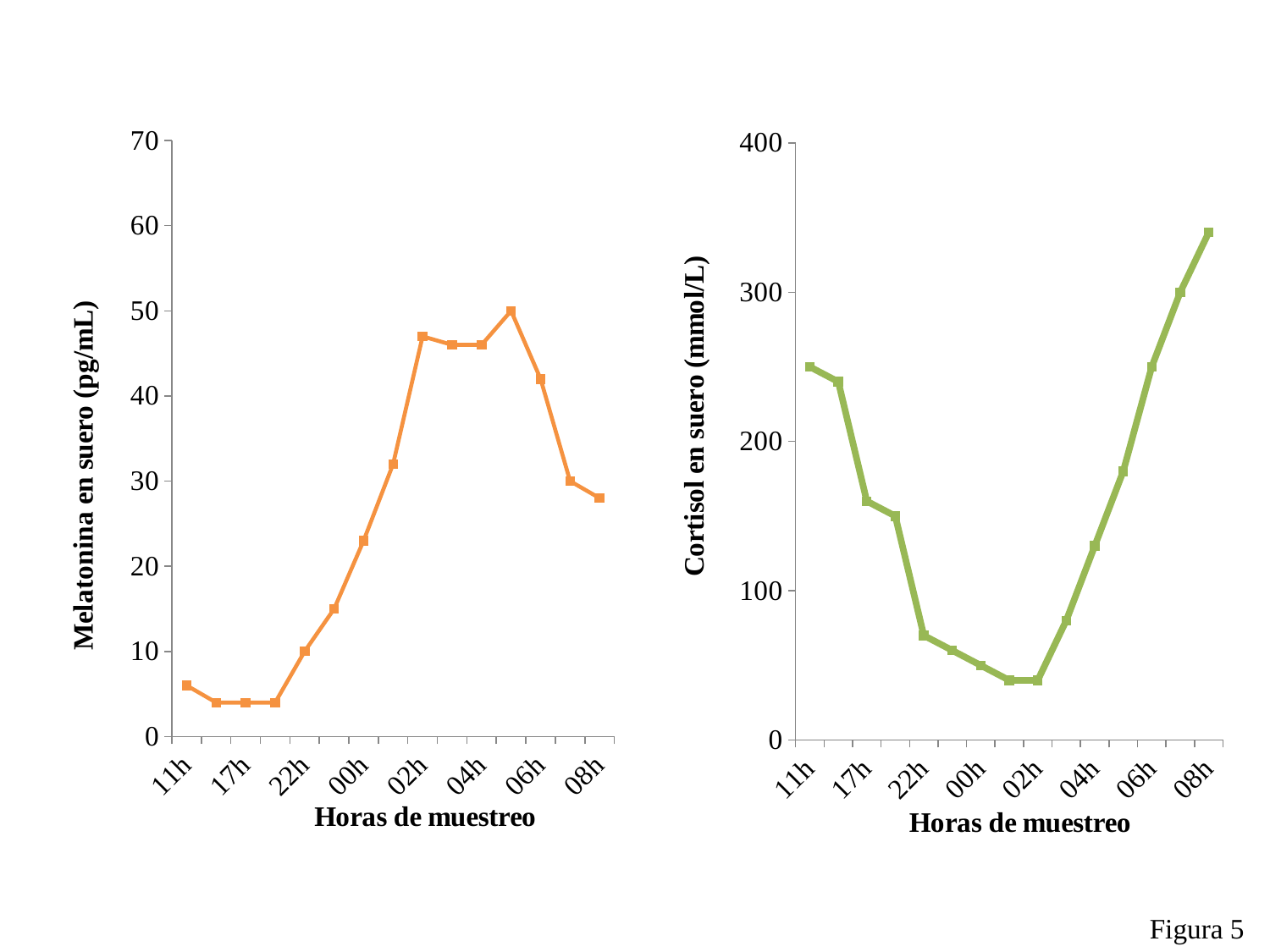
In the right chart, which is larger, the cortisol value at 08h or at 00h? 08h In the left chart, is the melatonin value at 17h greater or less than 10? less In the left chart, is the melatonin value at 00h greater or less than 20? greater What kind of chart is the left chart (Melatonina en suero)? line chart What is the y-axis label of the right chart? Cortisol en suero (mmol/L) In the right chart, is the cortisol value at 08h greater or less than 300? greater What kind of chart is the right chart (Cortisol en suero)? line chart In the right chart, at which labelled sampling hour is cortisol highest? 08h In the left chart, which is larger, the melatonin value at 02h or at 17h? 02h